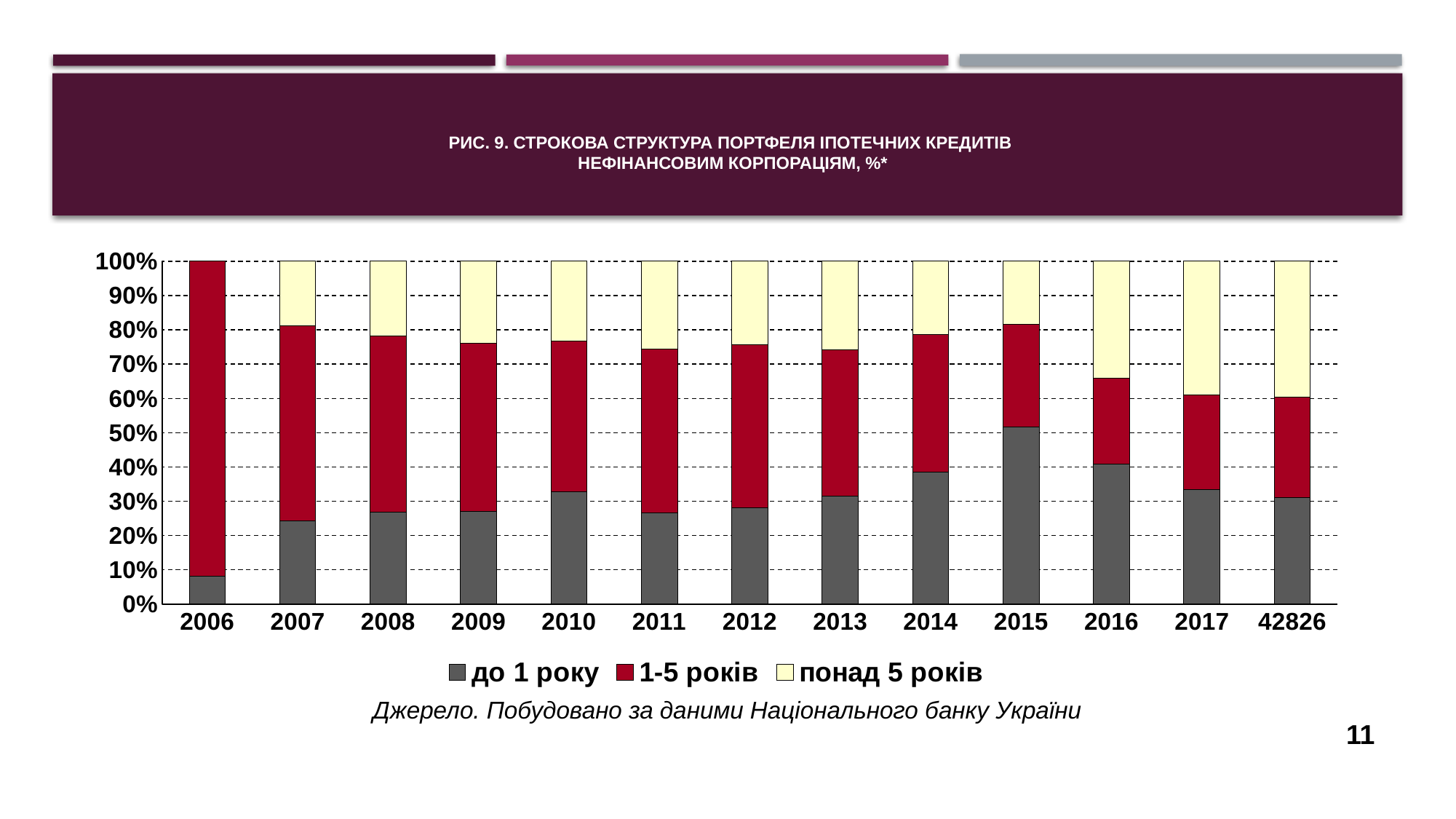
How many categories are shown along the x axis? 13 What is the title of the chart? РИС. 9. СТРОКОВА СТРУКТУРА ПОРТФЕЛЯ ІПОТЕЧНИХ КРЕДИТІВ НЕФІНАНСОВИМ КОРПОРАЦІЯМ, %* Which year has the larger share of 'до 1 року', 2015 or 2016? 2015 In which year is the share of 'до 1 року' the highest? 2015 Is the share of 'до 1 року' in 2006 greater or less than 10%? less Which year has the larger share of 'до 1 року', 2010 or 2011? 2010 Is the share of 'до 1 року' in 2017 greater or less than 30%? greater What kind of chart is shown on the slide? stacked bar chart Is the share of 'до 1 року' in 2015 greater or less than 50%? greater Which series are listed in the legend? до 1 року, 1-5 років, понад 5 років In which year is the share of 'до 1 року' the lowest? 2006 How many series does the legend list? 3